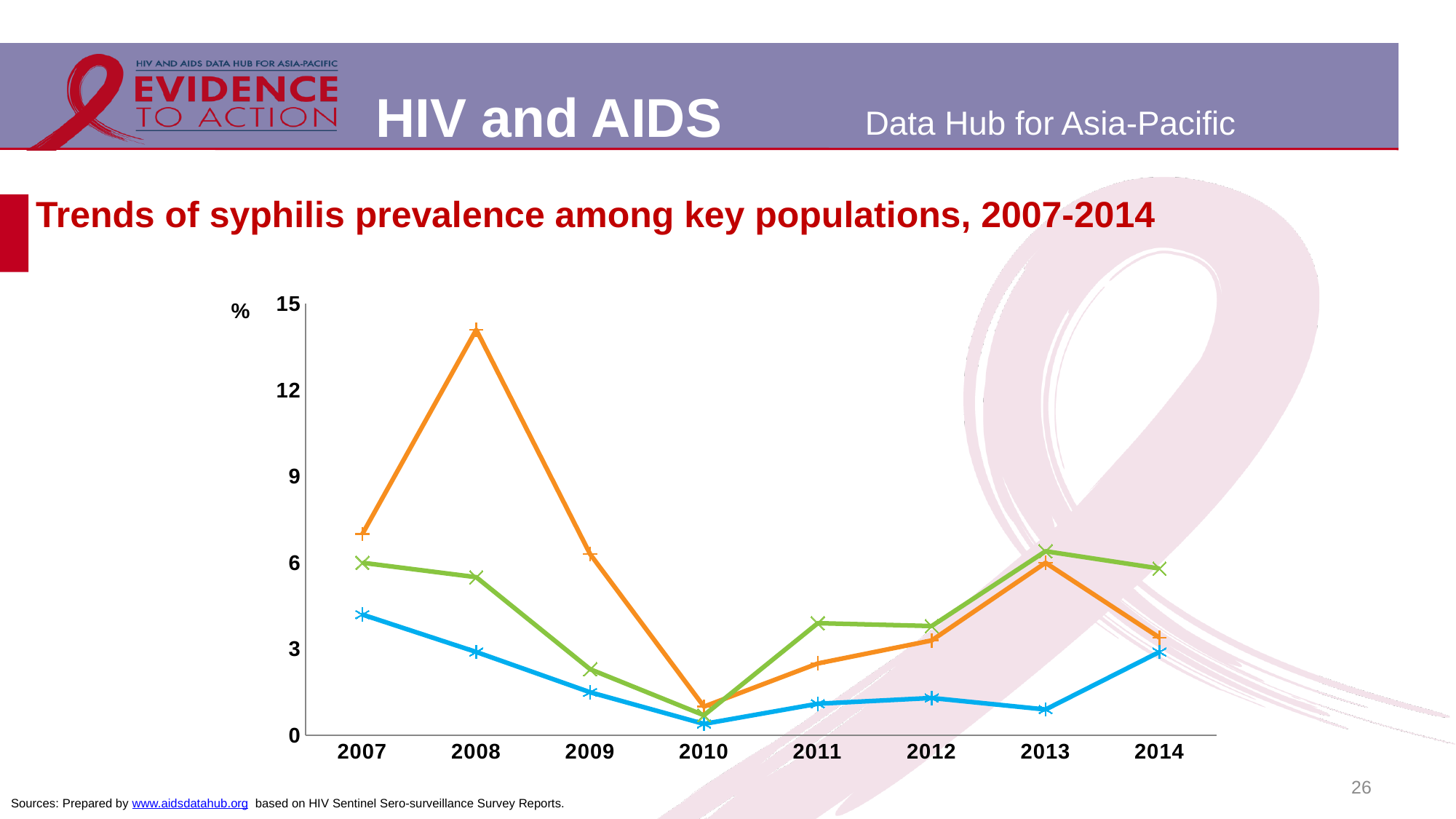
Is the value of the orange line in 2008 greater or less than 12? greater Is the value of the blue line in 2010 greater or less than 3? less What is the title of the chart on the slide? Trends of syphilis prevalence among key populations, 2007-2014 What kind of chart is shown on the slide? line chart In which year does the orange line reach its highest value? 2008 Does the orange line rise or fall between 2008 and 2010? fall Is the value of the green line in 2014 greater or less than 3? greater In 2013, which line has the higher value, the green line or the blue line? green line In which year does the blue line reach its highest value? 2007 In 2007, which line has the higher value, the orange line or the green line? orange line In which year does the orange line reach its lowest value? 2010 How many years are shown along the x axis of the chart? 8